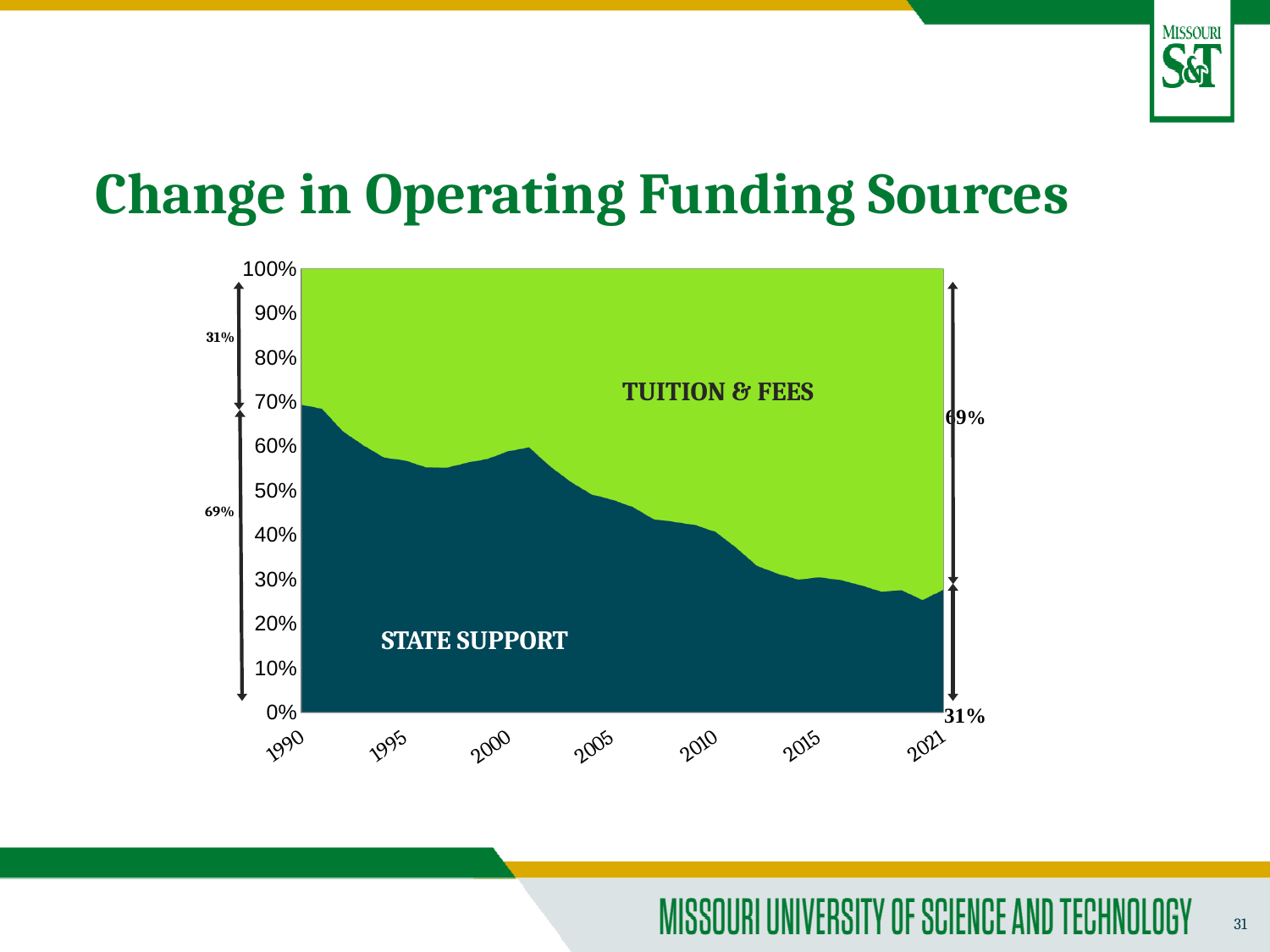
Does the State Support share rise or fall from 1990 to 2021? Fall In 1990, which funding source is larger, State Support or Tuition & Fees? State Support Does the Tuition & Fees share rise or fall from 1990 to 2021? Rise Is the State Support share in 2010 greater or less than 50%? less What is the title of the chart? Change in Operating Funding Sources In 2021, which funding source is larger, State Support or Tuition & Fees? Tuition & Fees What kind of chart is shown on the slide? Area chart What share of operating funding came from State Support in 2021? 31% What share of operating funding came from State Support in 1990? 69% What share of operating funding came from Tuition & Fees in 1990? 31% By how many percentage points did the State Support share drop between 1990 and 2021? 38 percentage points What share of operating funding came from Tuition & Fees in 2021? 69%